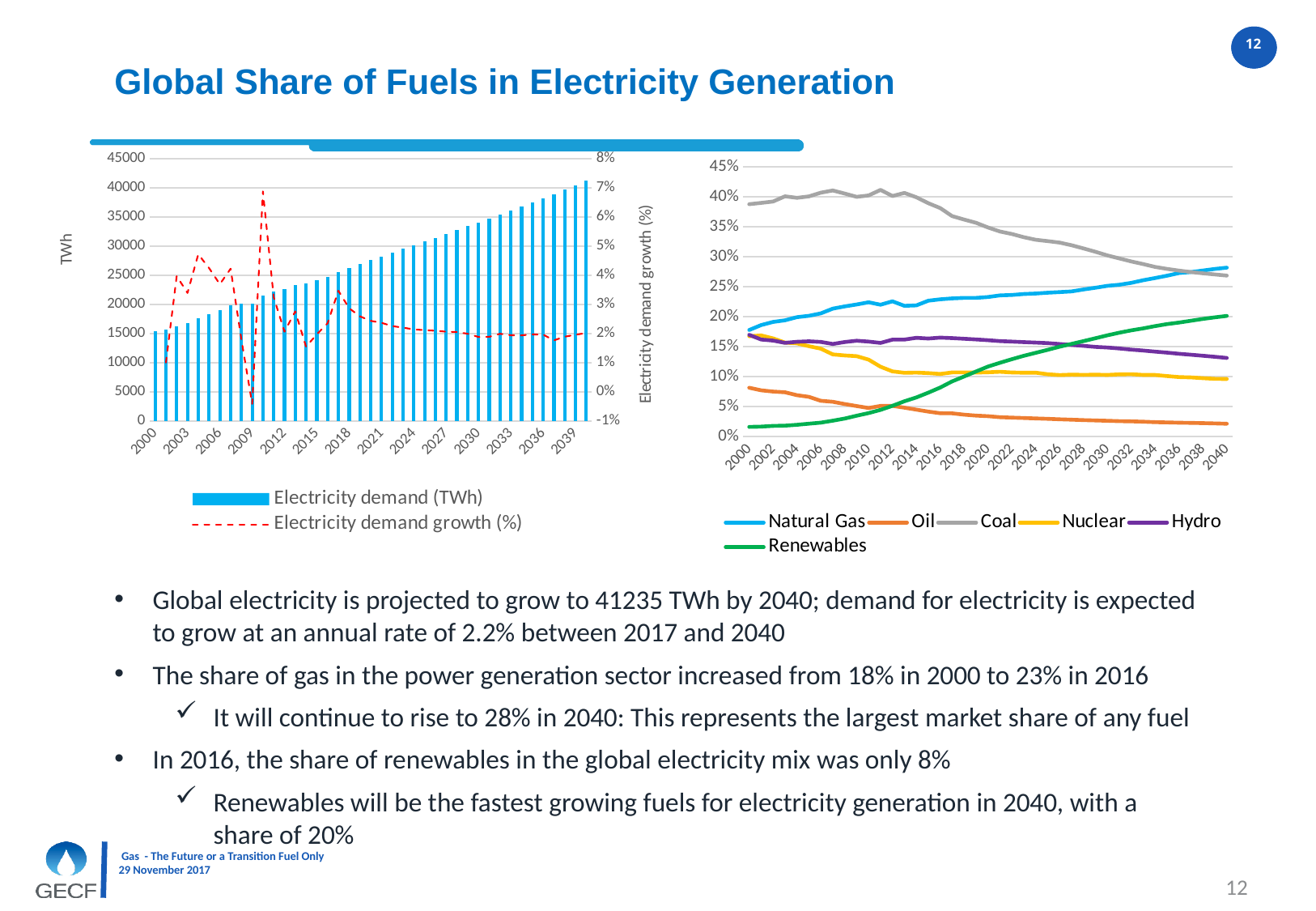
How many series does the legend of the right chart list? 6 In the right chart, which fuel has the lowest share in 2000? Renewables What kind of chart is the left chart showing electricity demand? A bar chart combined with a dashed line How many series does the legend of the left chart list? 2 In the left chart, does electricity demand (TWh) rise or fall from 2000 to 2040? Rise In the right chart, which fuel has the highest share in 2000? Coal In the left chart, is the electricity demand for 2036 greater or less than 35000 TWh? greater In the right chart, is the share of Oil in 2040 greater or less than 5%? less In the right chart, which has the larger share in 2040, Renewables or Hydro? Renewables In the left chart, is the electricity demand for 2000 greater or less than 20000 TWh? less In the right chart, does the share of Coal rise or fall from 2000 to 2040? Fall In the left chart, which year has the highest electricity demand (TWh)? 2040